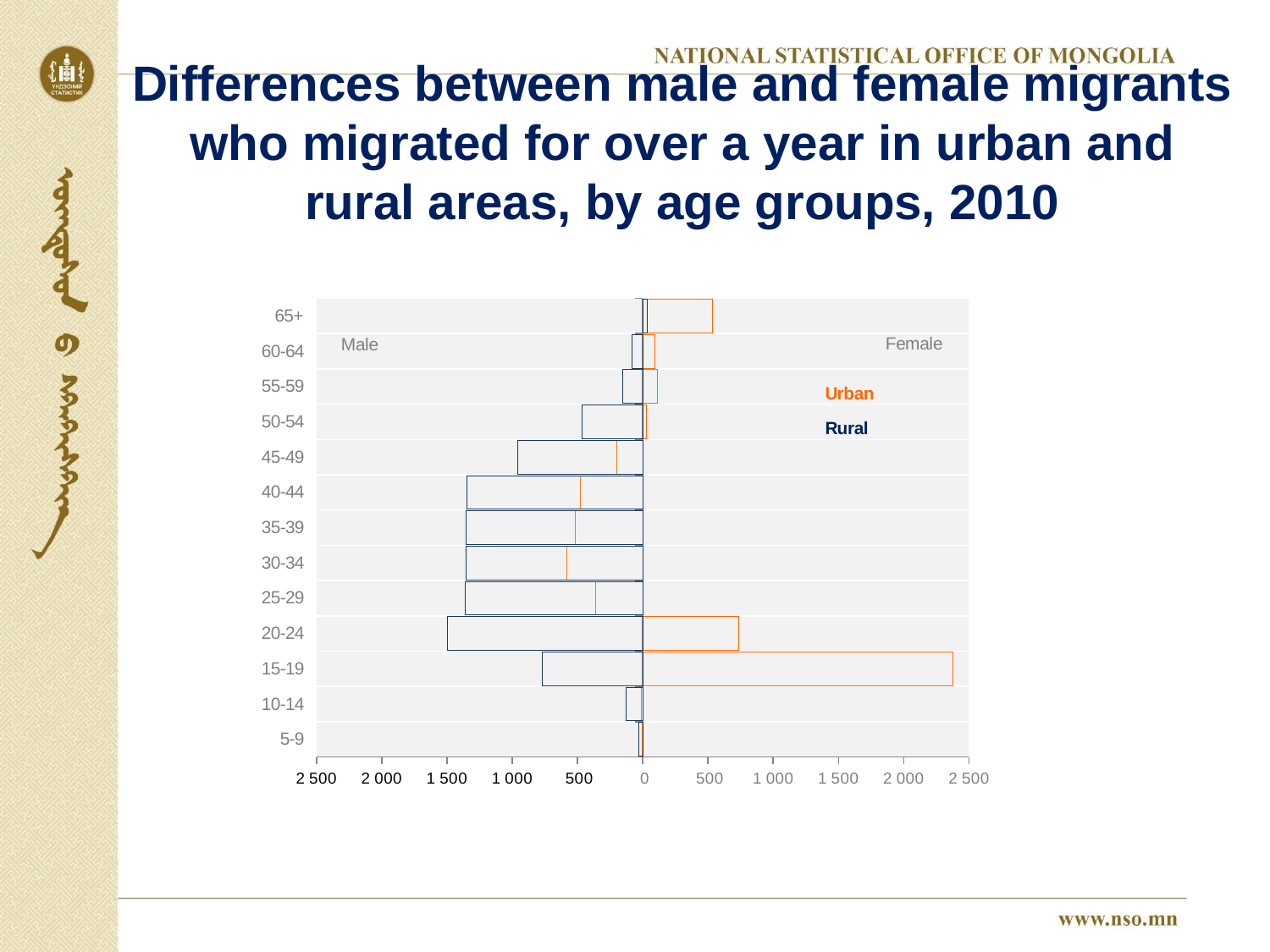
Is the Male Rural value for the 15-19 age group greater or less than 1 000? less Which age group has the largest Female Urban bar? 15-19 Which side of the chart shows the Male values? left Is the Female Urban value for the 15-19 age group greater or less than 2 000? greater Which is larger, the Female Urban value for 15-19 or for 20-24? 15-19 Which age group has the largest Male Rural bar? 20-24 How many series does the chart's legend list? 2 What kind of chart is shown on the slide? bar chart Is the Female Urban value for the 20-24 age group greater or less than 500? greater Which colour represents the Urban series in the chart? orange How many age groups are shown on the vertical axis of the chart? 13